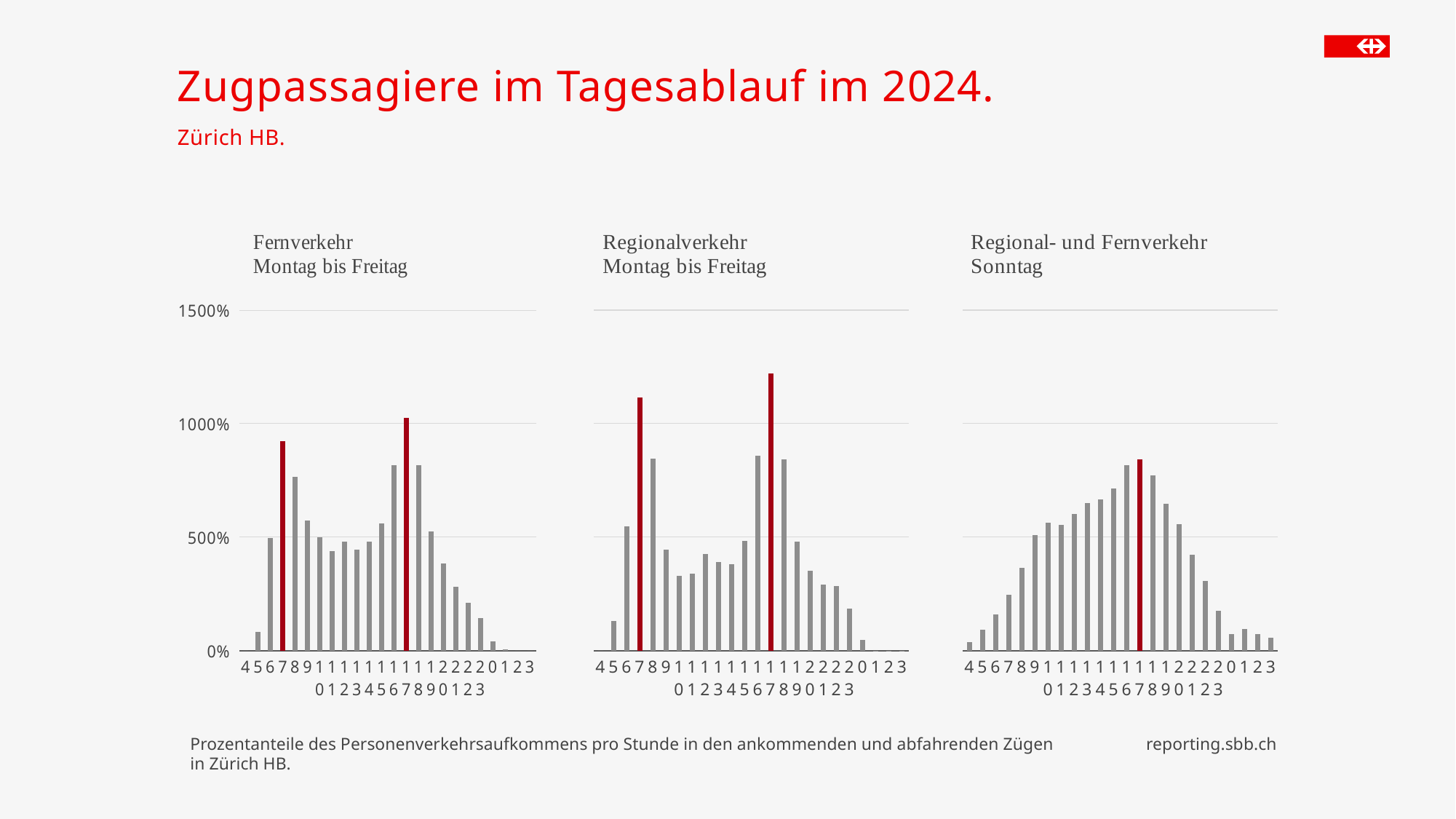
How many hourly categories does the 'Regionalverkehr Montag bis Freitag' chart show on its x axis? 24 In the 'Regionalverkehr Montag bis Freitag' chart, which hour has the highest value? 17 In the 'Regionalverkehr Montag bis Freitag' chart, which is larger, the value for hour 7 or the value for hour 8? hour 7 In the 'Fernverkehr Montag bis Freitag' chart, is the value for hour 7 greater or less than 500%? greater In the 'Fernverkehr Montag bis Freitag' chart, which hour has the highest value? 17 In the 'Regionalverkehr Montag bis Freitag' chart, is the value for hour 17 greater or less than 1000%? greater How many bar charts are shown on the slide? 3 What kind of chart is the 'Fernverkehr Montag bis Freitag' chart? bar chart In the 'Regional- und Fernverkehr Sonntag' chart, is the value for hour 4 greater or less than 500%? less What is the title of the slide? Zugpassagiere im Tagesablauf im 2024. In the 'Fernverkehr Montag bis Freitag' chart, which is larger, the value for hour 8 or the value for hour 9? hour 8